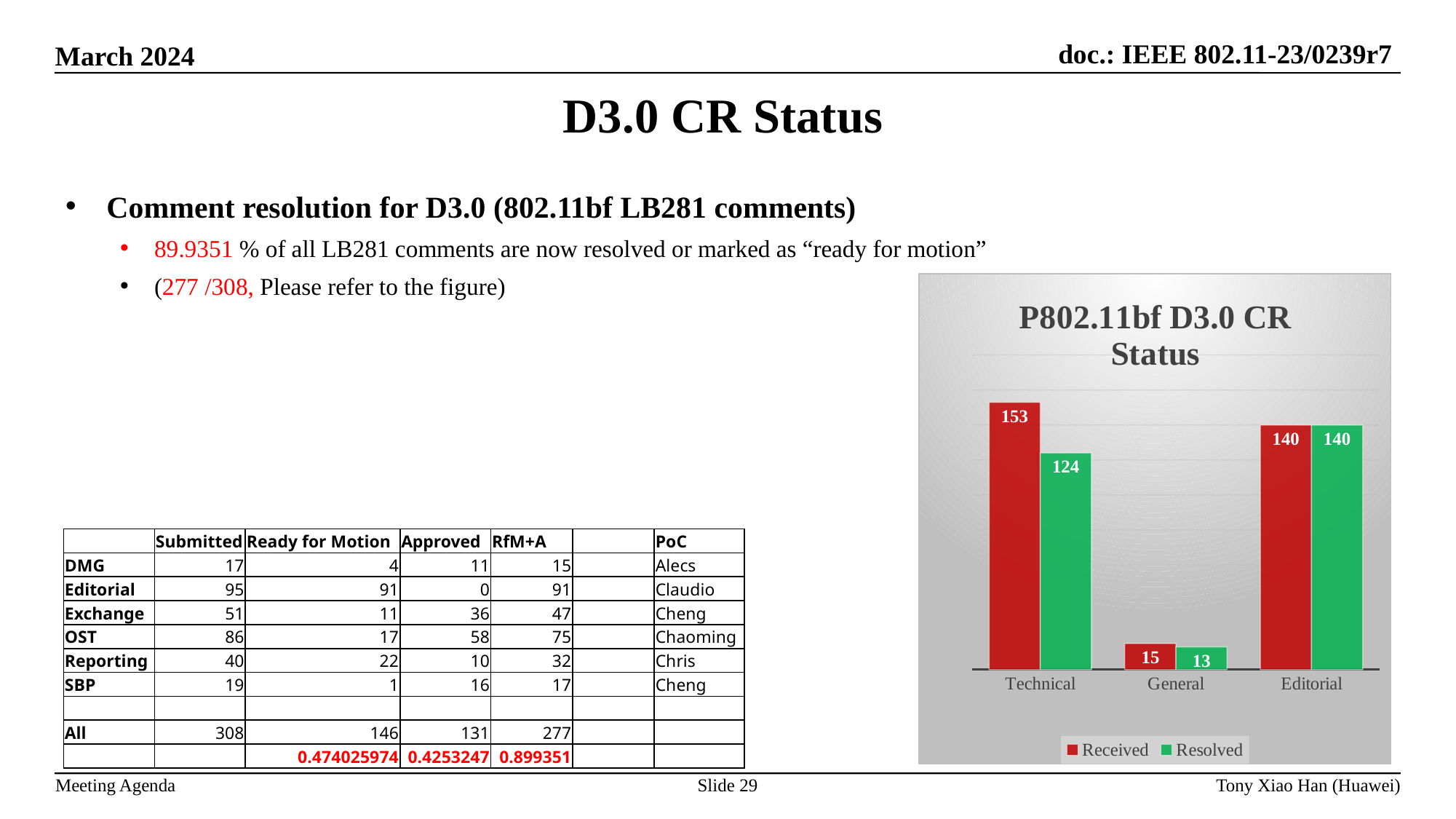
What is the difference between Received and Resolved for General? 2 Which category has the highest Received value? Technical How many series does the chart legend list? 2 What is the difference between Received and Resolved for Technical? 29 What type of chart is shown on the slide? Bar chart Which category has the lowest Resolved value? General What is the Received value for General? 15 What is the Resolved value for Editorial? 140 What is the Resolved value for Technical? 124 What is the Received value for Technical in the P802.11bf D3.0 CR Status chart? 153 Which is larger, the Resolved value for Technical or the Resolved value for Editorial? Editorial How many categories are shown on the x axis of the chart? 3